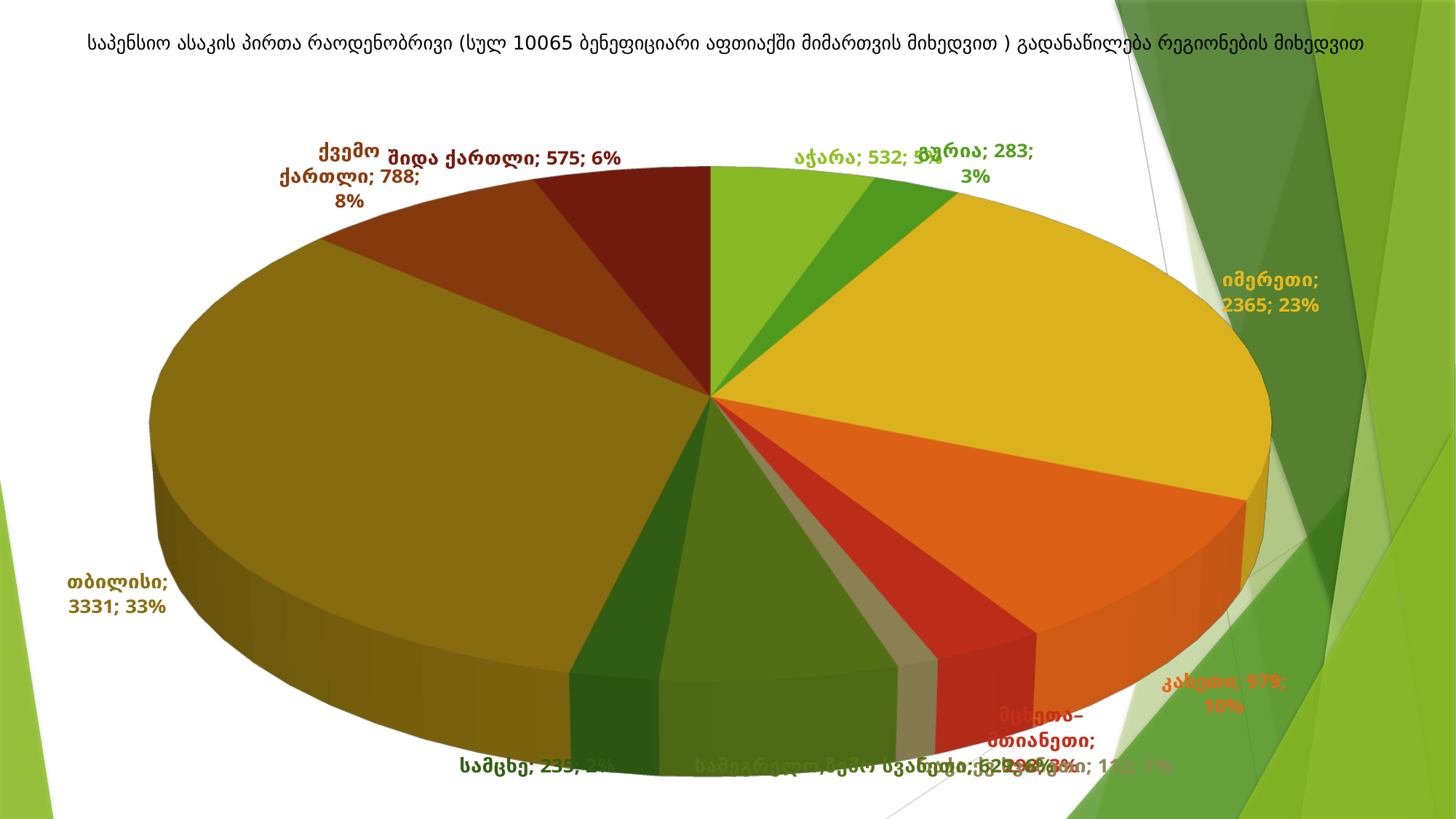
What value is shown for თბილისი? 3331 What value is shown for კახეთი? 979 What percentage share does იმერეთი have? 23% What value is shown for იმერეთი? 2365 Which is larger, the value for კახეთი or the value for ქვემო ქართლი? კახეთი What percentage share does თბილისი have? 33% What percentage share does შიდა ქართლი have? 6% What is the difference between the values for თბილისი and იმერეთი? 966 What value is shown for ქვემო ქართლი? 788 Which region has the largest slice of the pie? თბილისი What type of chart is shown on the slide? pie chart What value is shown for აჭარა? 532